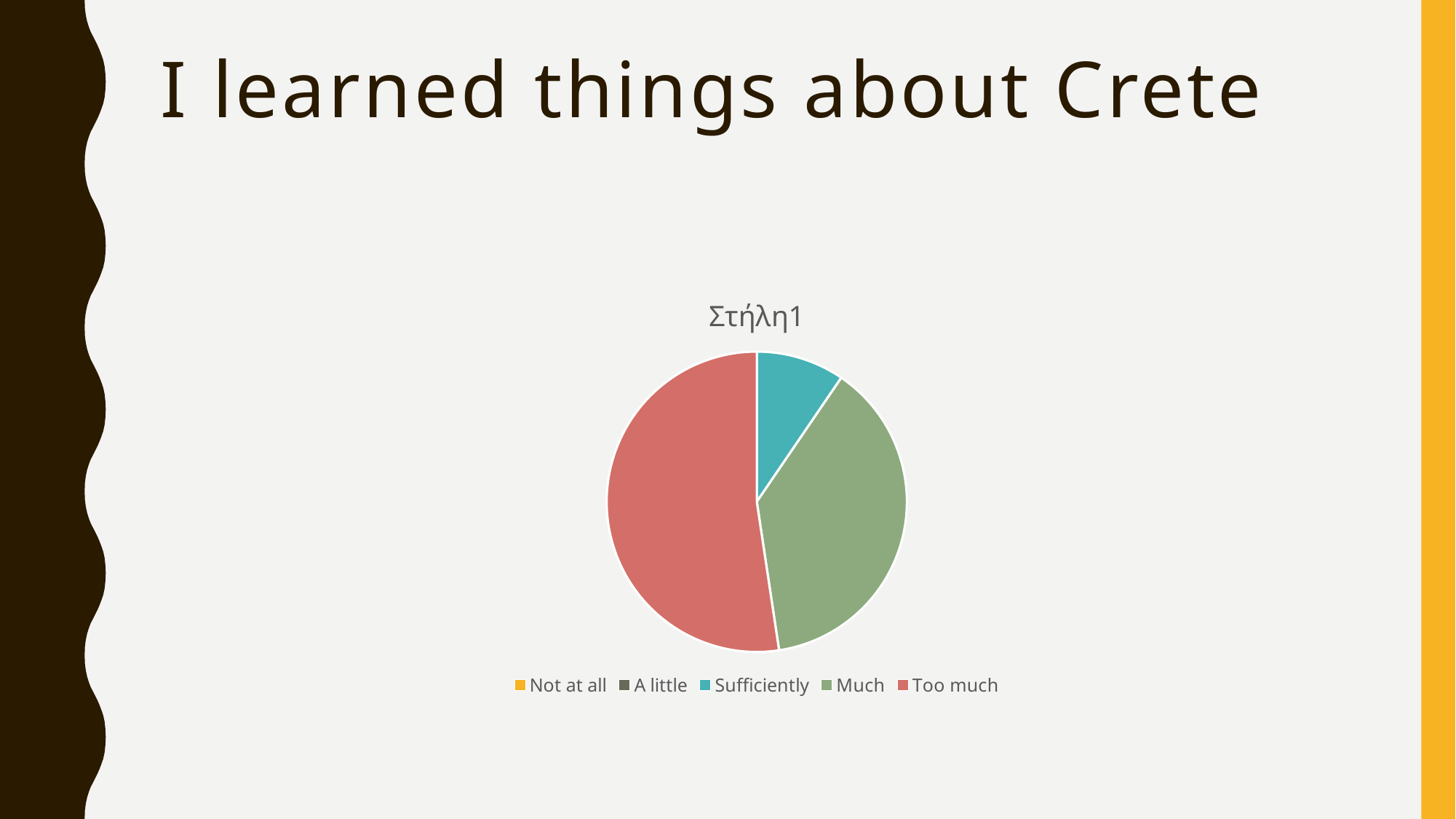
What colour is the "Too much" slice? red How many slices are visible in the pie? 3 Which category has the largest slice of the pie? Too much Which slice is larger, "Much" or "Sufficiently"? Much Which slice is larger, "Too much" or "Much"? Too much What is the title shown above the pie chart? Στήλη1 Of the slices visible in the pie, which category has the smallest? Sufficiently How many categories does the legend list? 5 What kind of chart is shown on the slide? pie chart Does the "Too much" slice take up more or less than half of the pie? more